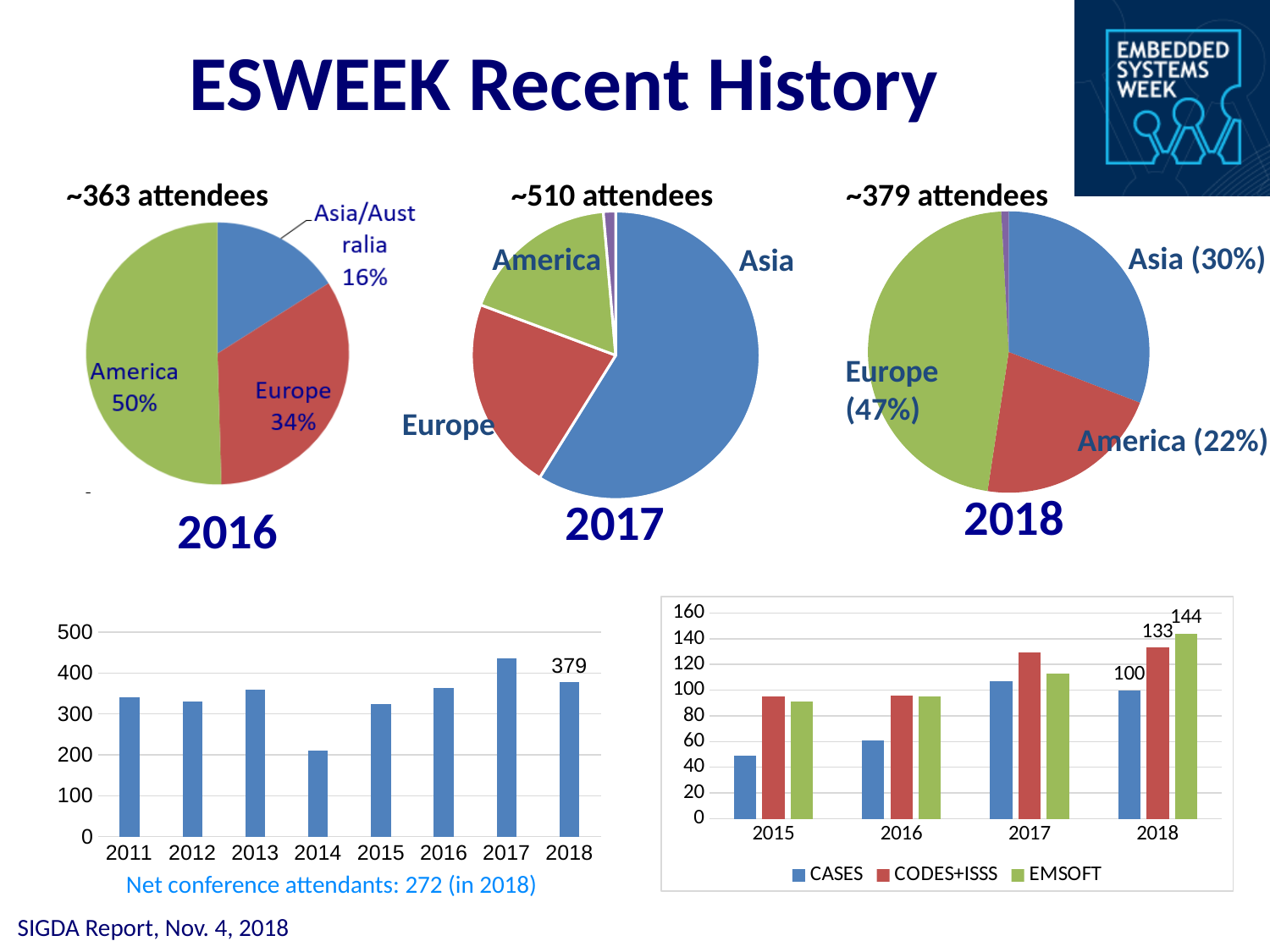
In the 2018 pie chart, what is the share for Asia? 30% In the 2017 pie chart, which region has the largest share of attendees? Asia In the 2018 pie chart, which region has the largest share of attendees? Europe In the bottom-right bar chart, how many series does the legend list? 3 In the bottom-right bar chart, what is the value for EMSOFT in 2018? 144 In the bottom-left bar chart of attendance by year, what is the value for 2018? 379 In the bottom-left bar chart of attendance by year, which year has the lowest value? 2014 In the 2016 pie chart, what share of attendees came from Europe? 34% In the bottom-right bar chart, what is the difference between EMSOFT and CASES in 2018? 44 In the bottom-left bar chart of attendance by year, is the value for 2014 greater or less than 300? less In the 2016 pie chart, what share of attendees came from America? 50% In the 2018 pie chart, how much larger is Europe's share than America's share? 25%